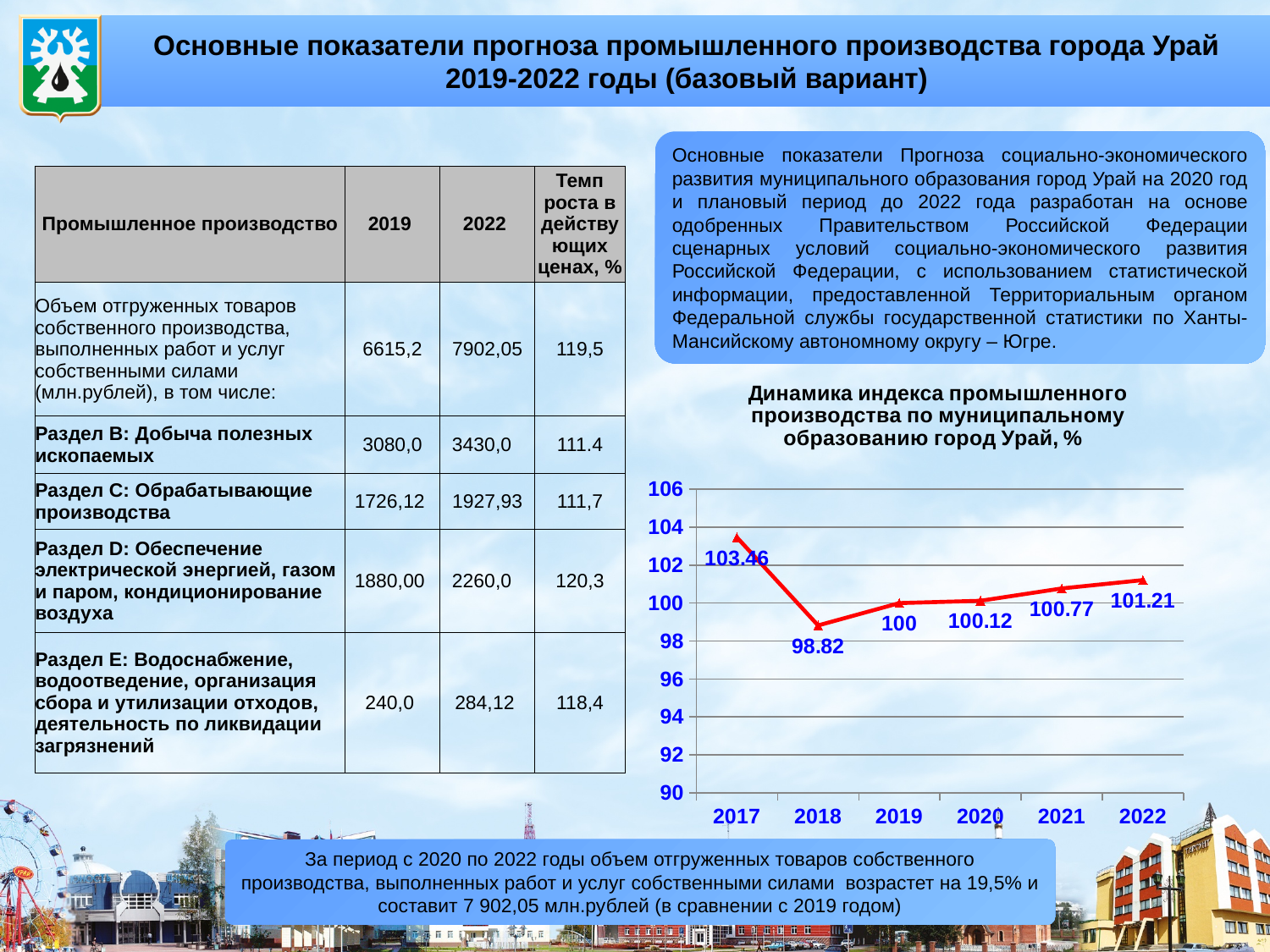
Which is larger, the value for 2021 or the value for 2022? 2022 How many years are plotted on the chart? 6 Which year has the lowest value on the chart? 2018 What is the value of the industrial production index for 2022? 101.21 What is the value of the industrial production index for 2020? 100.12 What is the difference between the values for 2017 and 2018? 4.64 Which year has the highest value on the chart? 2017 Do the values rise or fall from 2018 to 2022? rise What type of chart is shown on the slide? line chart What is the value of the industrial production index for 2018? 98.82 What is the value of the industrial production index for 2017? 103.46 Is the value for 2018 greater or less than 100? less